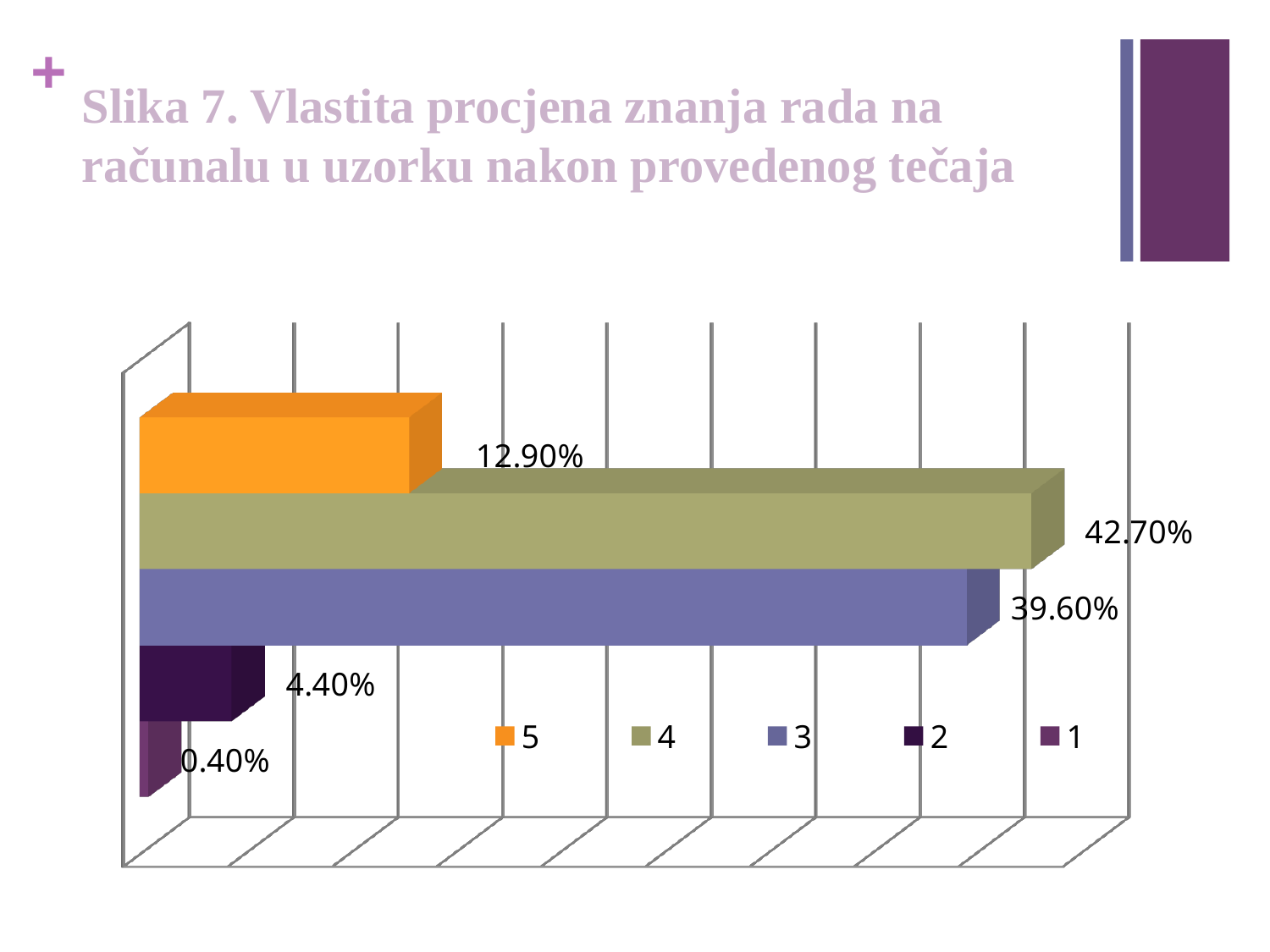
What value is shown for series 3? 39.60% Which series has the lowest value? 1 How many series does the legend list? 5 Which series has the highest value? 4 What value is shown for series 2? 4.40% What value is shown for series 5? 12.90% Which is larger, the value for series 5 or the value for series 2? 5 What kind of chart is shown on the slide? bar chart What is the difference between the values for series 4 and series 3? 3.10% What value is shown for series 1? 0.40% What value is shown for series 4? 42.70% What colour is the bar for series 5? orange